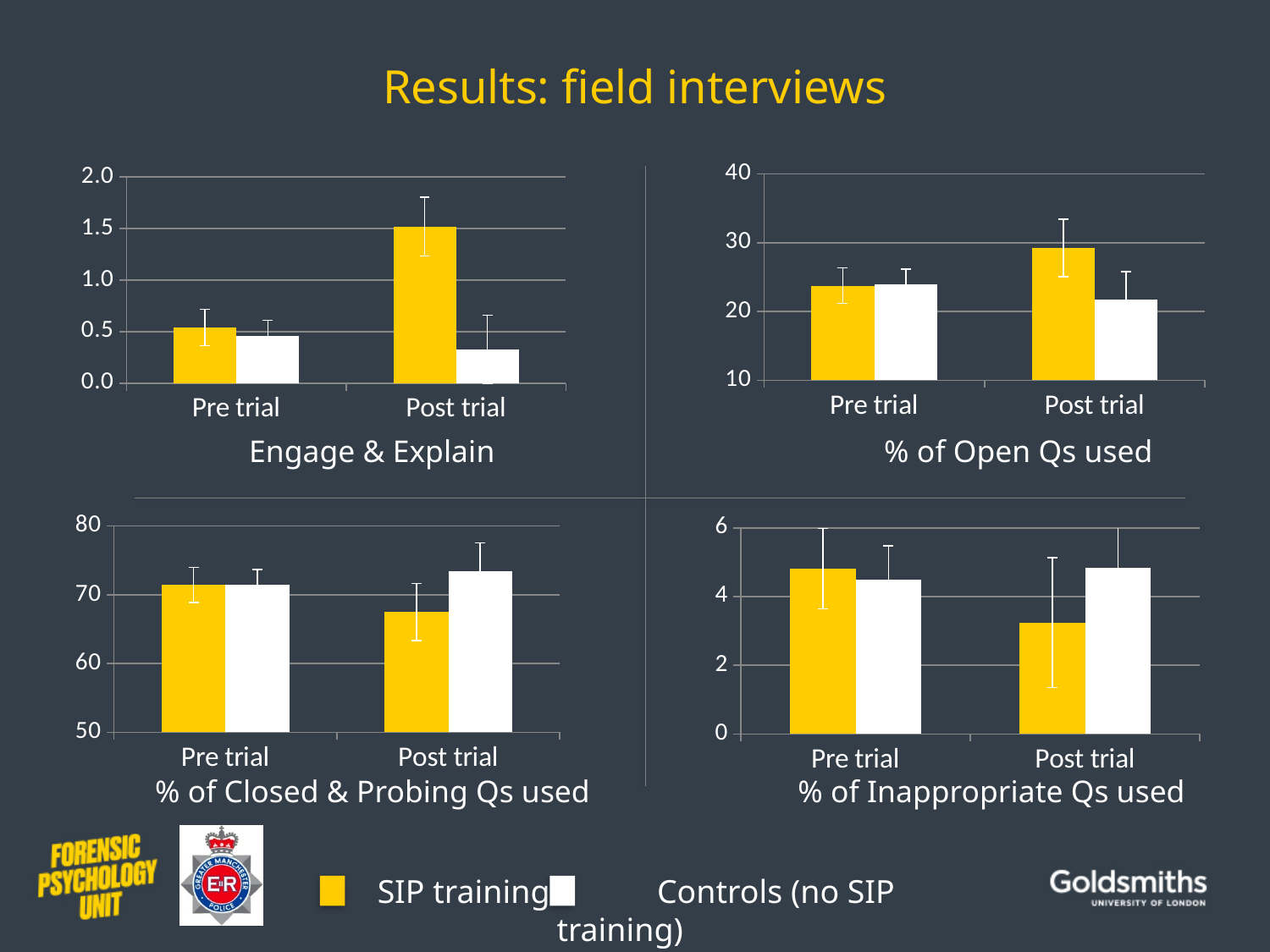
In the '% of Inappropriate Qs used' chart, is the Post trial value for SIP training greater or less than 4? less In the '% of Closed & Probing Qs used' chart, is the Post trial value for SIP training greater or less than 70? less What kind of chart is the 'Engage & Explain' chart? bar chart How many series does the legend at the bottom of the slide list? 2 In the '% of Inappropriate Qs used' chart, does the SIP training value rise or fall from Pre trial to Post trial? fall In the 'Engage & Explain' chart, which series has the larger Post trial value, SIP training or Controls? SIP training In the '% of Closed & Probing Qs used' chart, which series has the larger Post trial value, SIP training or Controls? Controls In the 'Engage & Explain' chart, does the SIP training value rise or fall from Pre trial to Post trial? rise In the 'Engage & Explain' chart, is the Post trial value for SIP training greater or less than 1.0? greater In the '% of Open Qs used' chart, which series has the larger Post trial value, SIP training or Controls? SIP training How many categories are shown on the x axis of the '% of Open Qs used' chart? 2 Which colour represents the SIP training series in the charts? yellow